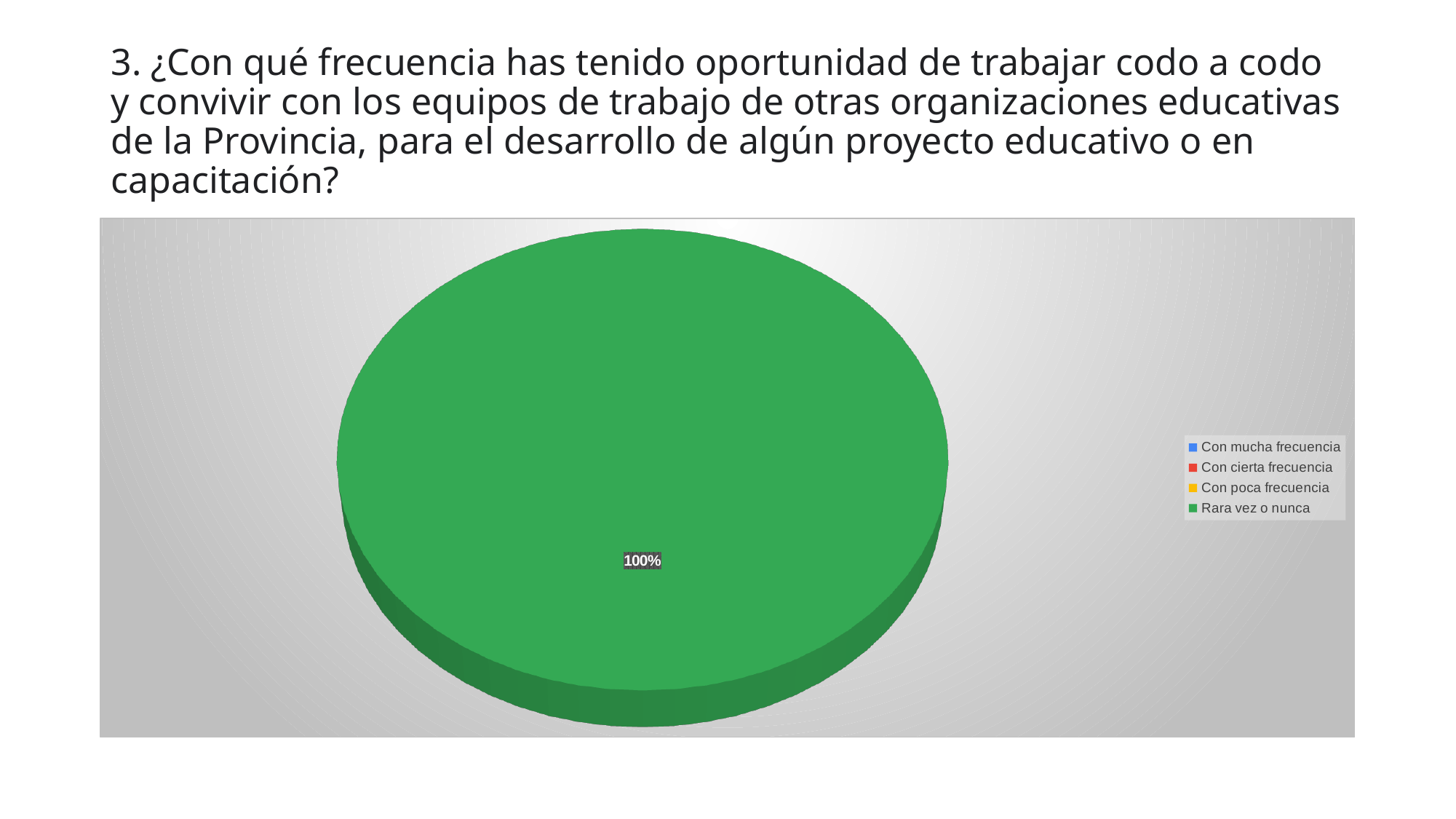
Which legend entry is shown in blue? Con mucha frecuencia Is the share for "Rara vez o nunca" greater or less than 50%? greater Which is larger, the share for "Rara vez o nunca" or the share for "Con poca frecuencia"? Rara vez o nunca What share of the pie does "Rara vez o nunca" represent? 100% How many entries does the legend list? 4 How many slices are visible in the pie? 1 What kind of chart is shown on the slide? pie chart Which category has the largest share of the pie? Rara vez o nunca What colour is the slice for "Rara vez o nunca"? green